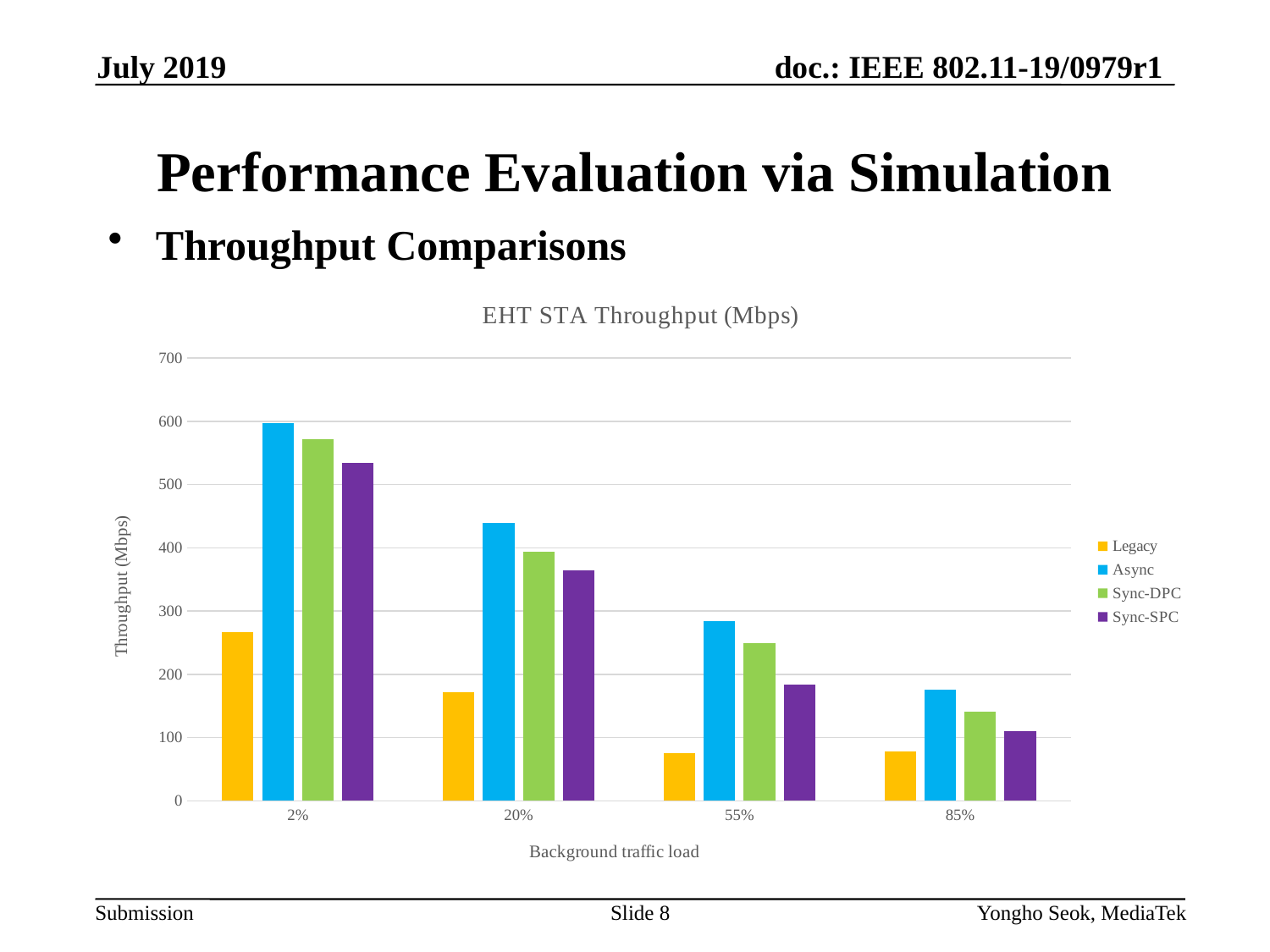
At 20% background traffic load, which is larger: the Async throughput or the Sync-SPC throughput? Async Is the Async throughput at 2% background traffic load greater or less than 500? greater What kind of chart is shown on the slide? bar chart Is the Sync-SPC throughput at 55% background traffic load greater or less than 200? less How many background traffic load categories are shown on the x axis? 4 Is the Legacy throughput at 55% background traffic load greater or less than 100? less How many series does the legend list? 4 Which series has the highest throughput at 2% background traffic load? Async What is the title of the chart? EHT STA Throughput (Mbps) Does the Async throughput rise or fall as the background traffic load increases from 2% to 85%? fall Which series has the lowest throughput at 85% background traffic load? Legacy What is the label of the x axis? Background traffic load